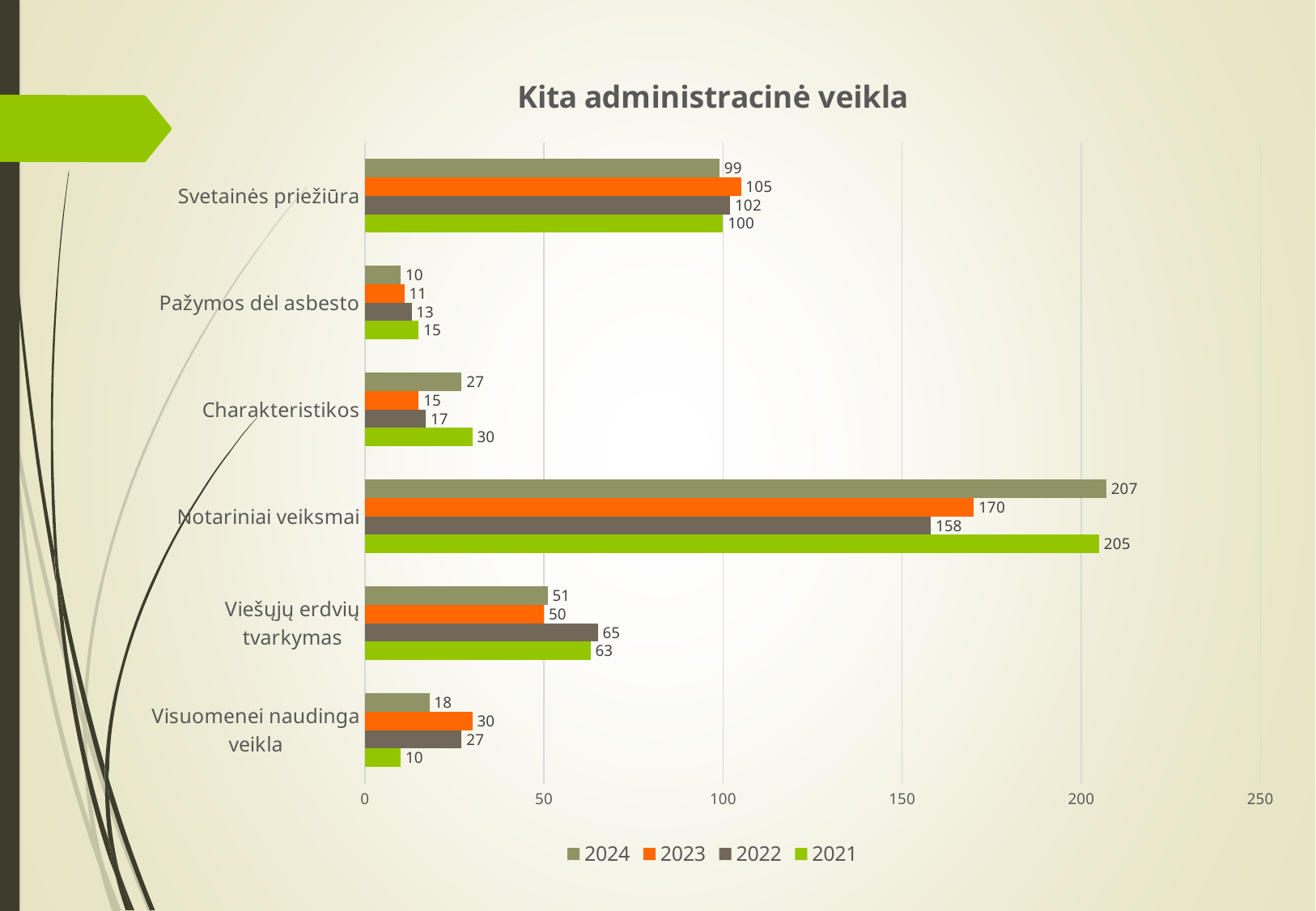
What is the value for Svetainės priežiūra in 2023? 105 What is the value for Notariniai veiksmai in 2024? 207 What is the value for Viešųjų erdvių tvarkymas in 2022? 65 What is the value for Visuomenei naudinga veikla in 2021? 10 How many series does the legend list? 4 What kind of chart is shown on the slide? Bar chart How many categories are shown on the chart? 6 Is the value for Notariniai veiksmai in 2021 greater or less than 150? greater What is the difference between the 2024 and 2022 values for Notariniai veiksmai? 49 Which category has the highest value in the 2023 series? Notariniai veiksmai Which is larger for Charakteristikos: the 2021 value or the 2022 value? 2021 Which category has the lowest value in the 2024 series? Pažymos dėl asbesto